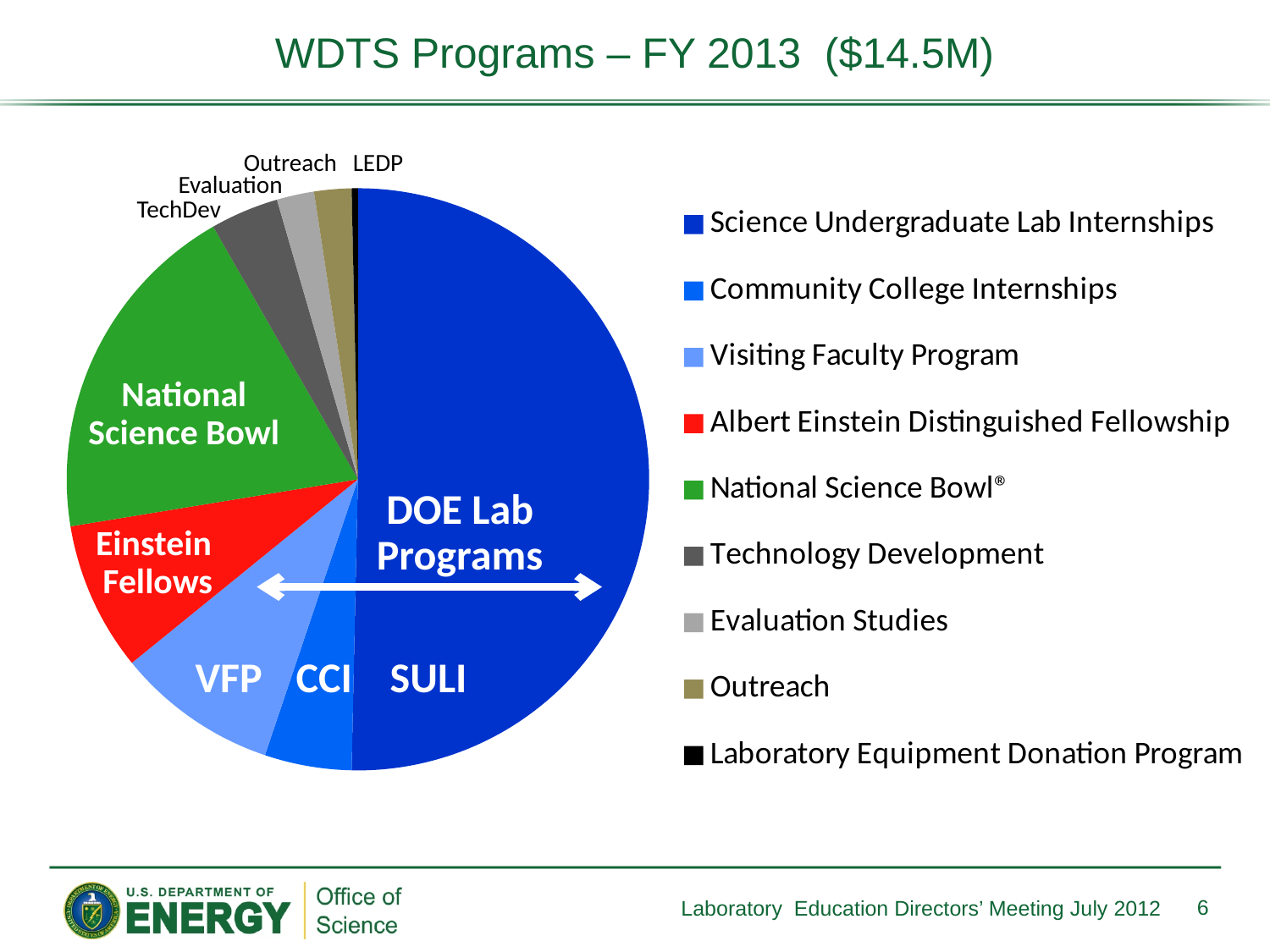
Which slice is larger: Visiting Faculty Program or Community College Internships? Visiting Faculty Program Which slice is larger: Technology Development or Laboratory Equipment Donation Program? Technology Development Which program has the largest slice of the pie chart? Science Undergraduate Lab Internships What is the title of the chart on the slide? WDTS Programs – FY 2013 ($14.5M) How many slices does the pie chart have? 9 Which slice is larger: Science Undergraduate Lab Internships or National Science Bowl? Science Undergraduate Lab Internships How many programs does the legend of the pie chart list? 9 Which program has the smallest slice of the pie chart? Laboratory Equipment Donation Program What kind of chart is shown on the slide? Pie chart What total budget amount is given in the chart title? $14.5M